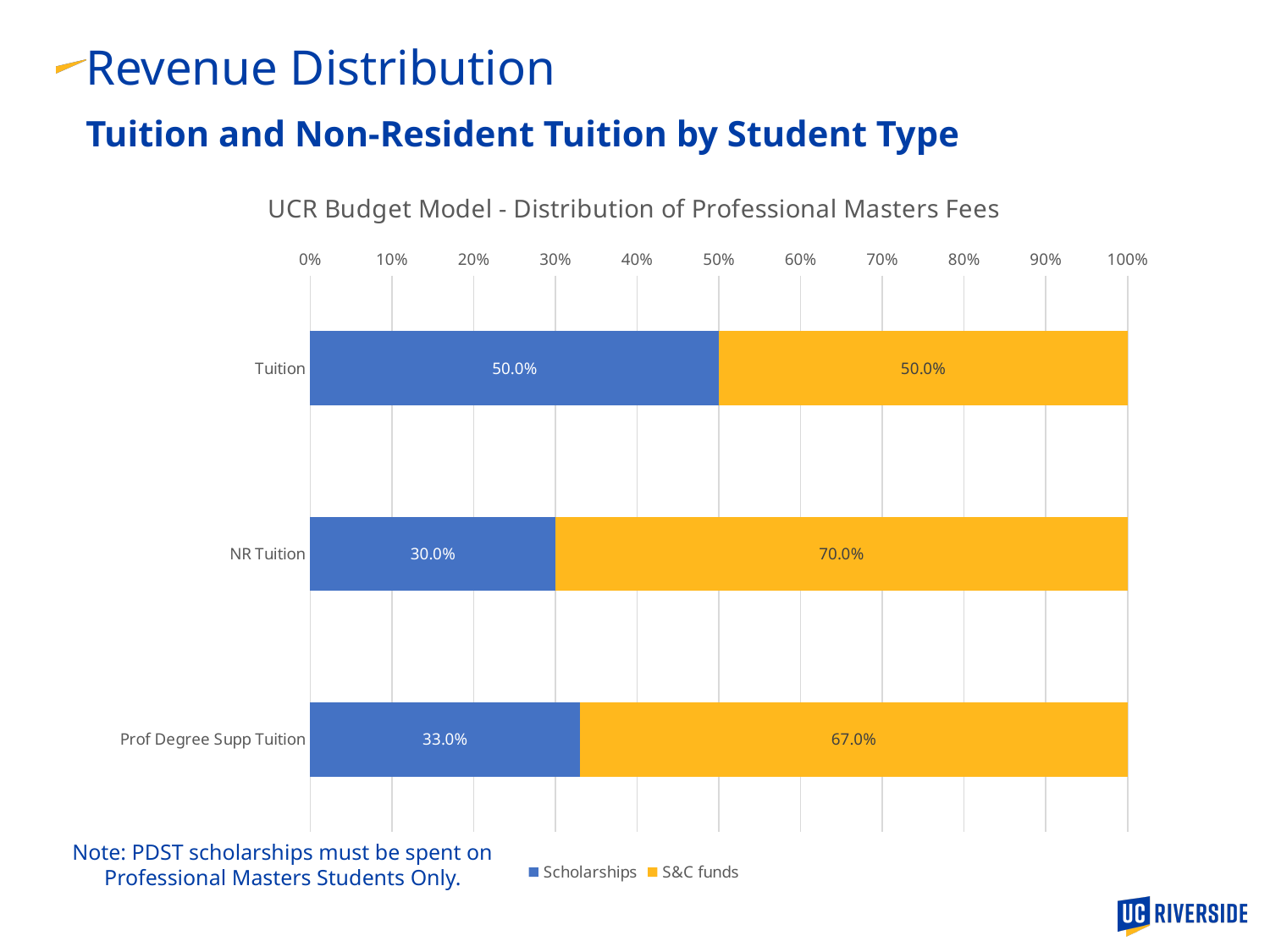
What kind of chart is shown on the slide? Stacked bar chart What is the Scholarships value for Tuition? 50.0% Which category has the lowest Scholarships share? NR Tuition Which category has the highest Scholarships share? Tuition What is the S&C funds value for Prof Degree Supp Tuition? 67.0% What is the S&C funds value for NR Tuition? 70.0% How many series does the legend list? 2 What is the title of the chart? UCR Budget Model - Distribution of Professional Masters Fees What is the difference between the S&C funds value for NR Tuition and the S&C funds value for Tuition? 20.0% What is the Scholarships value for Prof Degree Supp Tuition? 33.0% How many categories are shown on the chart? 3 Which is larger for NR Tuition: Scholarships or S&C funds? S&C funds